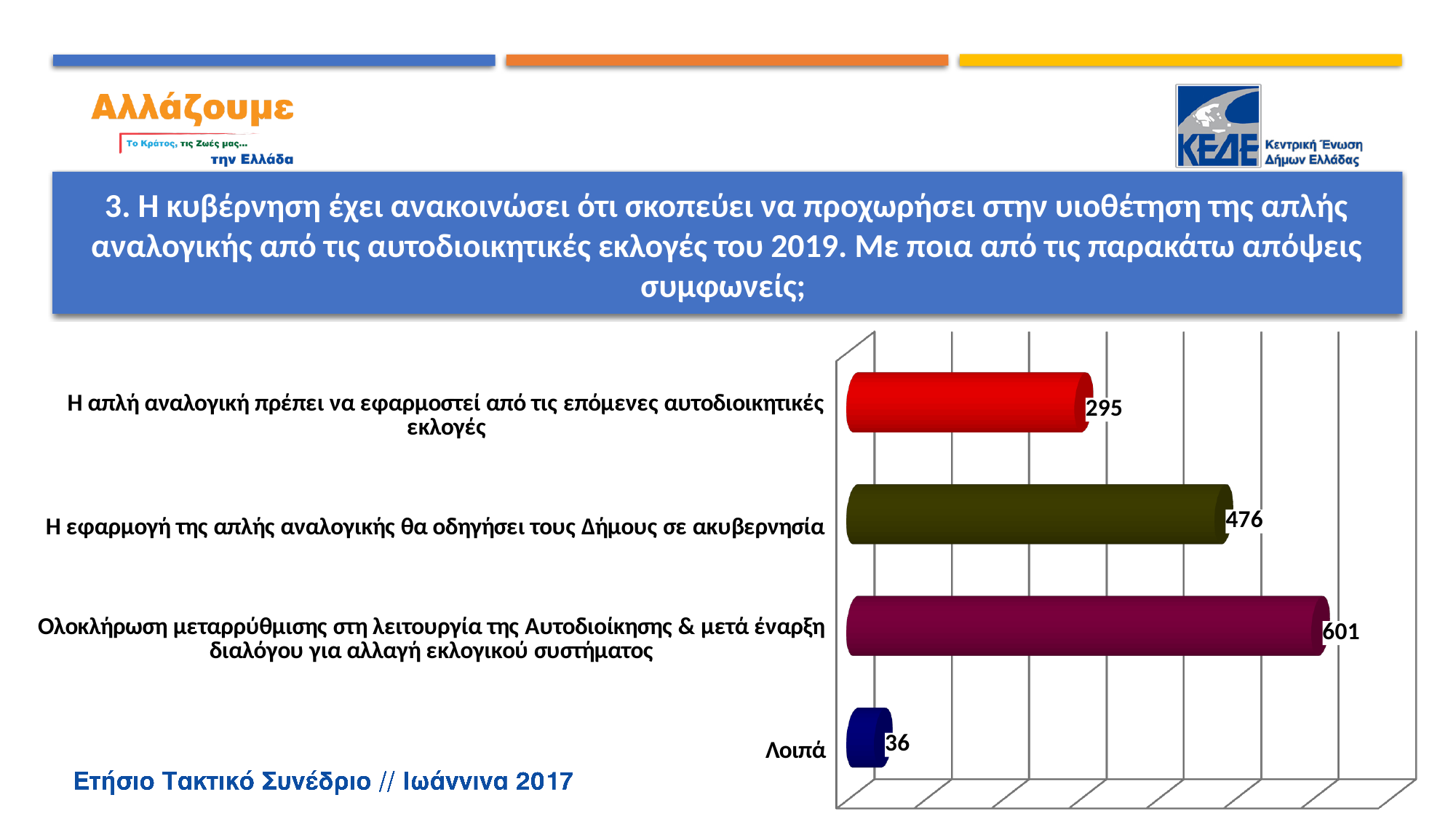
What value is shown for "Η απλή αναλογική πρέπει να εφαρμοστεί από τις επόμενες αυτοδιοικητικές εκλογές"? 295 What value is shown for "Ολοκλήρωση μεταρρύθμισης στη λειτουργία της Αυτοδιοίκησης & μετά έναρξη διαλόγου για αλλαγή εκλογικού συστήματος"? 601 What value is shown for "Η εφαρμογή της απλής αναλογικής θα οδηγήσει τους Δήμους σε ακυβερνησία"? 476 What value is shown for the category "Λοιπά"? 36 Which is larger: the value for "Η απλή αναλογική πρέπει να εφαρμοστεί από τις επόμενες αυτοδιοικητικές εκλογές" or the value for "Λοιπά"? Η απλή αναλογική πρέπει να εφαρμοστεί από τις επόμενες αυτοδιοικητικές εκλογές What is the difference between the values for "Ολοκλήρωση μεταρρύθμισης..." (601) and "Η εφαρμογή της απλής αναλογικής..." (476)? 125 What colour is the bar for "Λοιπά"? Dark blue Which category has the highest value? Ολοκλήρωση μεταρρύθμισης στη λειτουργία της Αυτοδιοίκησης & μετά έναρξη διαλόγου για αλλαγή εκλογικού συστήματος What is the difference between the values for "Η εφαρμογή της απλής αναλογικής..." and "Η απλή αναλογική πρέπει να εφαρμοστεί..."? 181 How many categories are shown in the chart? 4 Which category has the lowest value? Λοιπά What kind of chart is shown on the slide? Bar chart